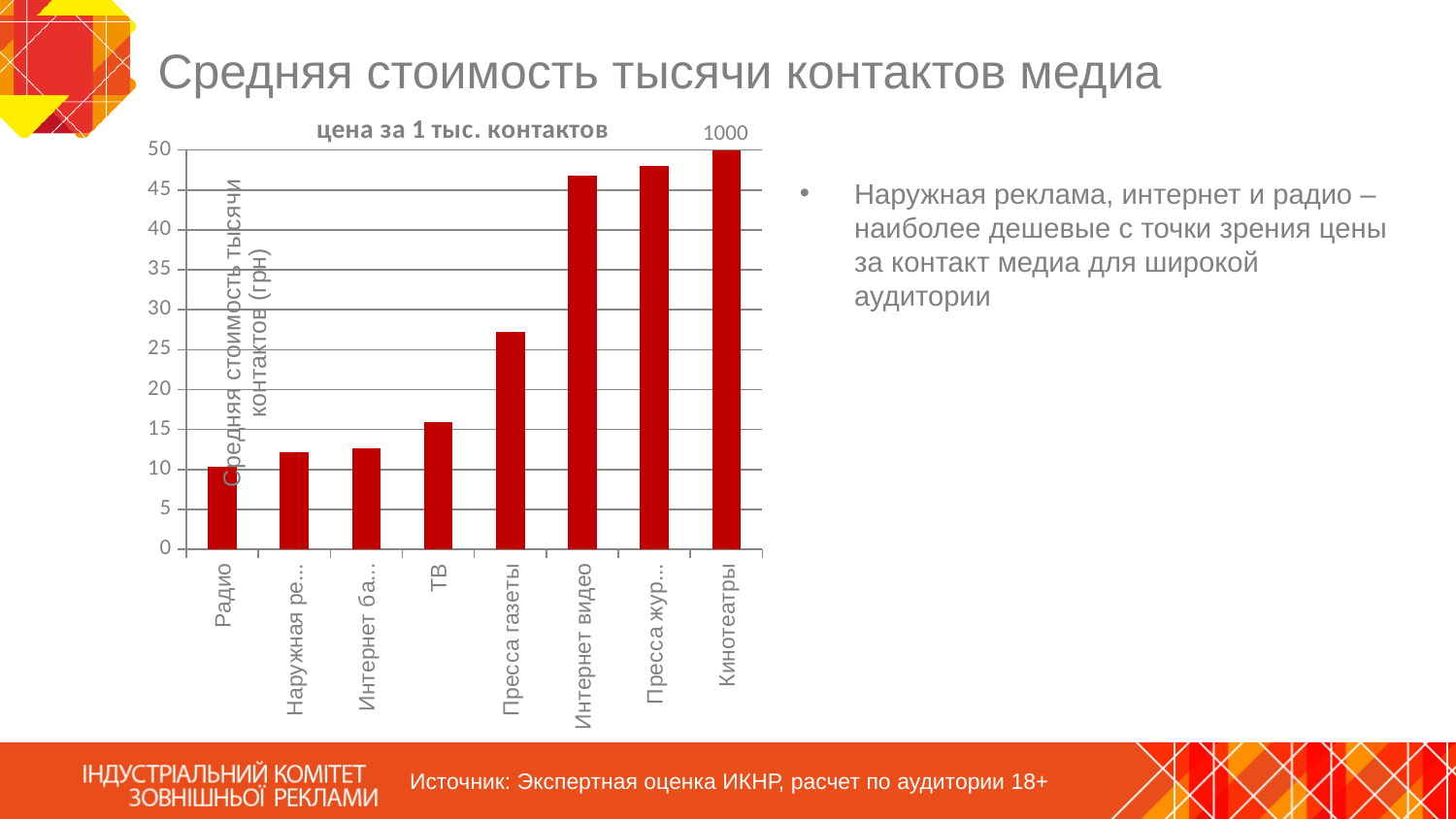
How many categories (bars) are shown in the chart? 8 Which category has the lowest value in the chart? Радио Is the value for Пресса газеты greater or less than 25? greater What value is printed as the data label above the Кинотеатры bar? 1000 Is the value for Радио greater or less than 15? less Which category has the highest value in the chart? Кинотеатры What is the title of the chart? цена за 1 тыс. контактов Do the bar values rise or fall from left to right along the x axis? rise Is the value for ТВ greater or less than 20? less What is the label on the vertical axis of the chart? Средняя стоимость тысячи контактов (грн) Which is larger, the value for ТВ or the value for Пресса газеты? Пресса газеты What type of chart is shown on the slide? bar chart